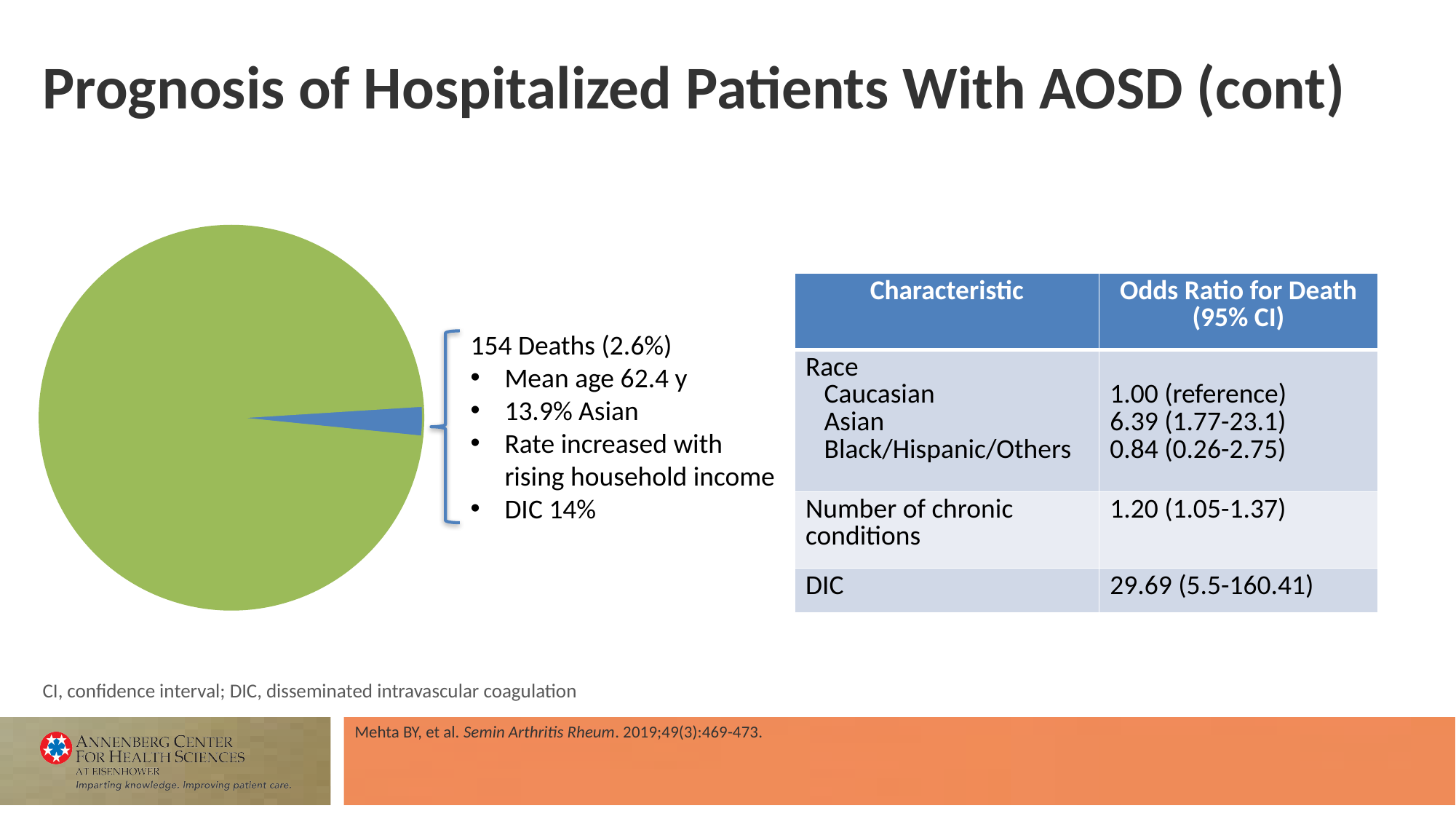
What percentage of the deaths slice is noted as Asian in the annotation next to the pie chart? 13.9% What share of the pie does the small blue slice representing deaths account for? 2.6% What colour is the slice of the pie chart that represents deaths? blue How many deaths does the small blue slice of the pie chart represent? 154 Which slice of the pie chart is the largest? the green slice What is the mean age listed for the deaths slice of the pie chart? 62.4 y What share of the pie does the green slice account for, given the deaths slice is 2.6%? 97.4% Is the green slice or the blue slice of the pie chart larger? the green slice What kind of chart is shown on the left of the slide? pie chart Which slice of the pie chart is the smallest? the blue slice (deaths)